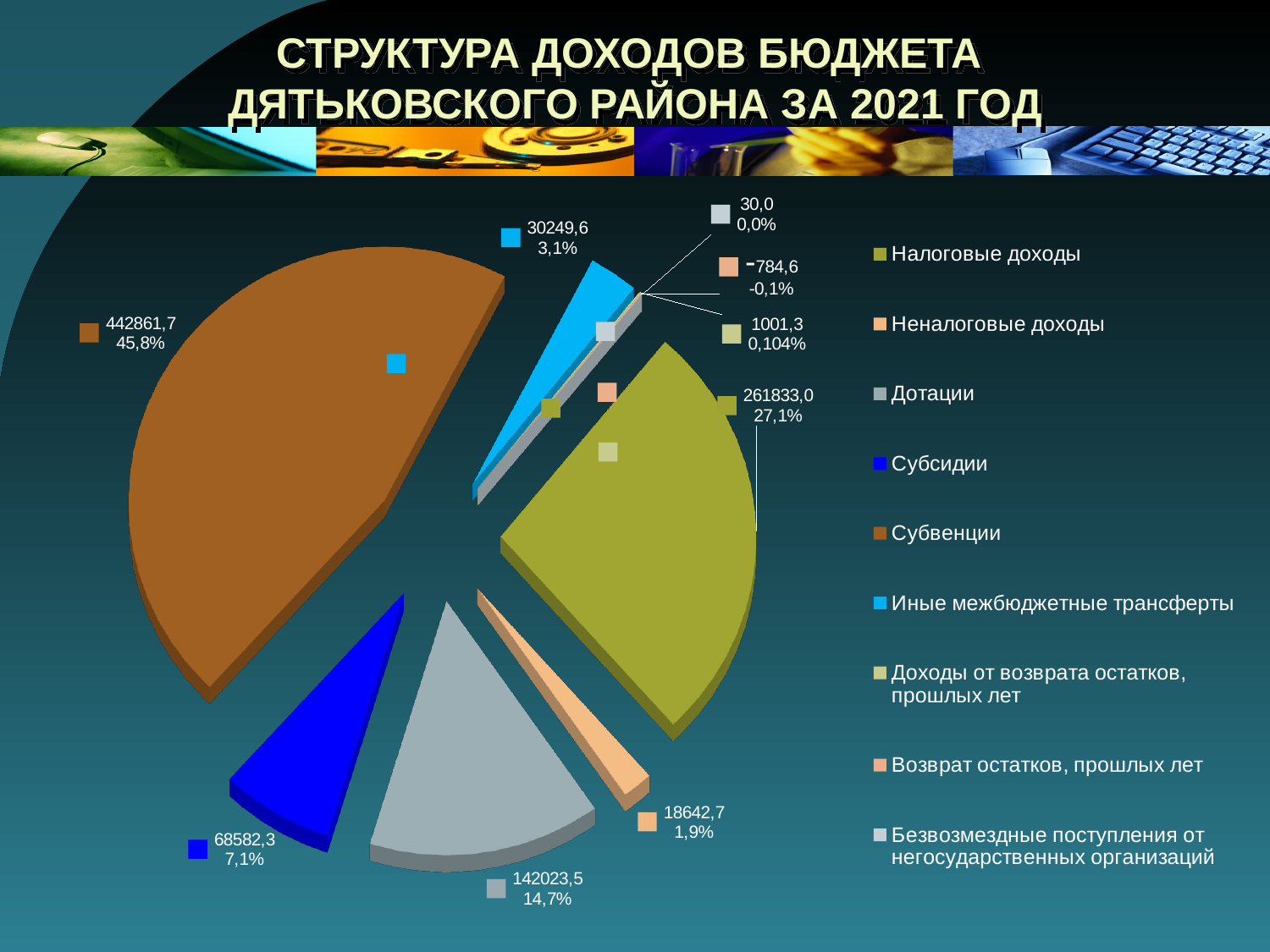
Which category has the largest slice of the pie? Субвенции What is the difference between the values for Субвенции and Налоговые доходы? 181028,7 What is the value shown for Субвенции? 442861,7 What is the value shown for Субсидии? 68582,3 What share of the pie does Субвенции take? 45,8% What percentage is shown for Дотации? 14,7% What kind of chart is shown on the slide? pie chart What percentage is shown for Иные межбюджетные трансферты? 3,1% Which is larger, the value for Дотации or the value for Субсидии? Дотации What is the title of the chart on the slide? СТРУКТУРА ДОХОДОВ БЮДЖЕТА ДЯТЬКОВСКОГО РАЙОНА ЗА 2021 ГОД What is the value shown for Налоговые доходы? 261833,0 How many categories does the legend of the pie chart list? 9